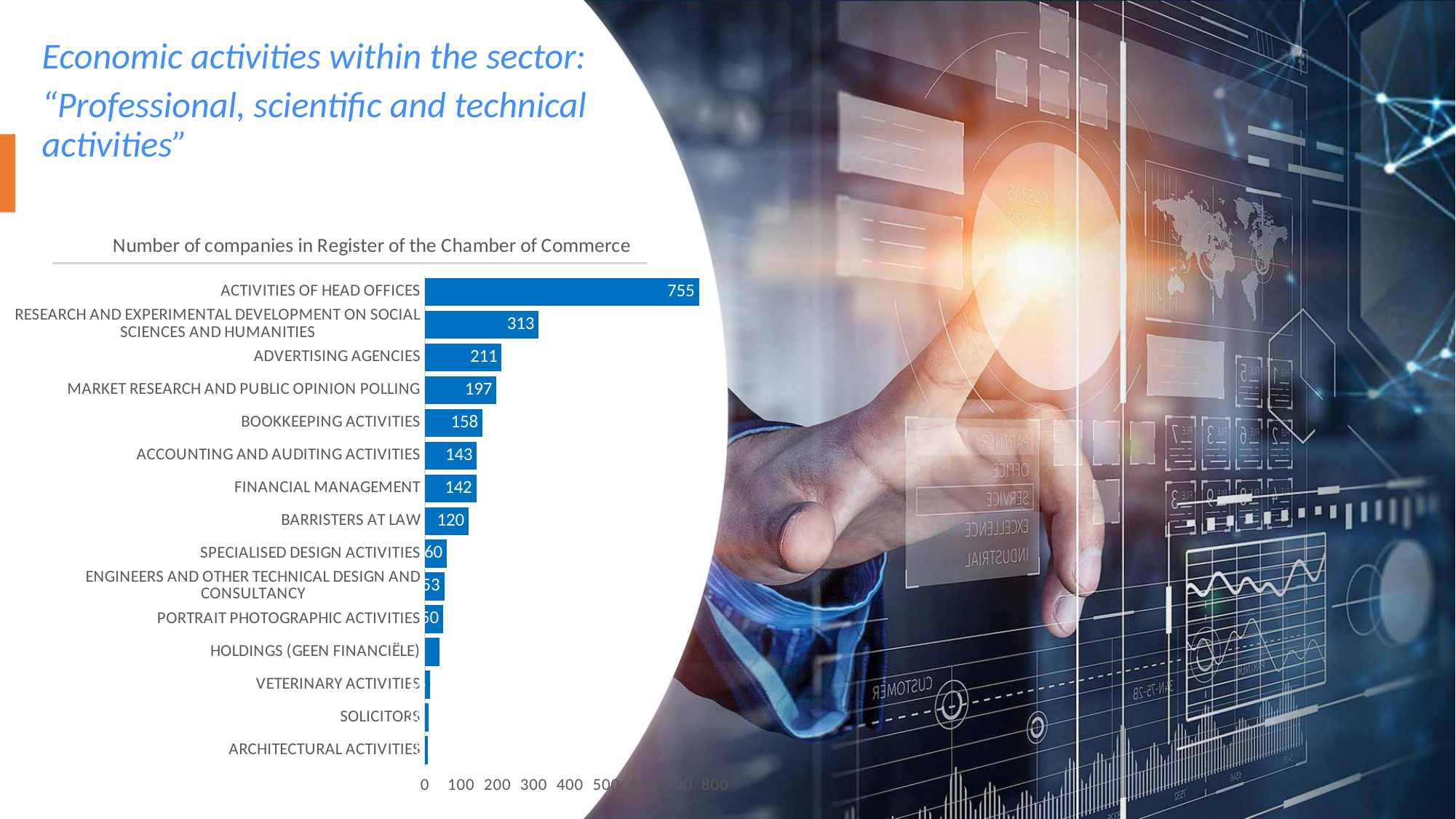
What is the number of companies for ACTIVITIES OF HEAD OFFICES? 755 Is the value for HOLDINGS (GEEN FINANCIËLE) greater or less than 100? less What is the title of the chart? Number of companies in Register of the Chamber of Commerce What is the number of companies for BOOKKEEPING ACTIVITIES? 158 How many categories are shown in the chart? 15 Which has more companies, MARKET RESEARCH AND PUBLIC OPINION POLLING or BOOKKEEPING ACTIVITIES? MARKET RESEARCH AND PUBLIC OPINION POLLING What is the difference between ACCOUNTING AND AUDITING ACTIVITIES and FINANCIAL MANAGEMENT? 1 Which category has the highest number of companies? ACTIVITIES OF HEAD OFFICES What kind of chart is shown on the slide? bar chart What is the difference between ACTIVITIES OF HEAD OFFICES and RESEARCH AND EXPERIMENTAL DEVELOPMENT ON SOCIAL SCIENCES AND HUMANITIES? 442 What is the number of companies for BARRISTERS AT LAW? 120 What is the number of companies for ADVERTISING AGENCIES? 211